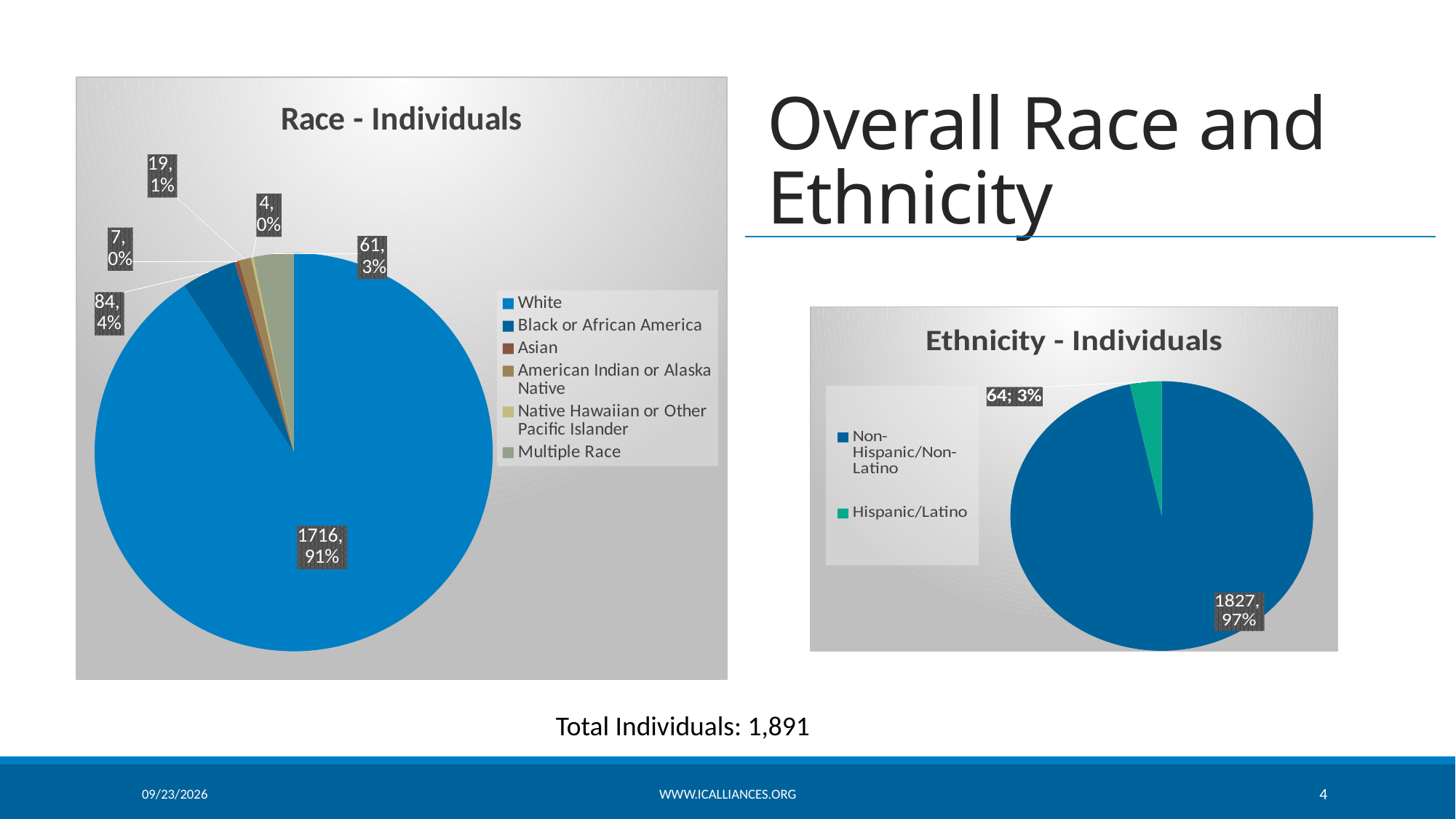
In the Race - Individuals chart, how many categories does the legend list? 6 In the Ethnicity - Individuals chart, which category has the smaller slice? Hispanic/Latino In the Race - Individuals chart, what is the difference between the White count and the Black or African America count? 1632 What kind of chart is the Ethnicity - Individuals chart? Pie chart In the Ethnicity - Individuals chart, how many categories does the legend list? 2 In the Race - Individuals chart, how many individuals are White? 1716 In the Race - Individuals chart, which category has the largest slice? White In the Race - Individuals chart, how many individuals are Black or African America? 84 In the Ethnicity - Individuals chart, how many individuals are Non-Hispanic/Non-Latino? 1827 In the Race - Individuals chart, what share of the pie is Multiple Race? 3% In the Race - Individuals chart, what percentage of individuals are White? 91% In the Ethnicity - Individuals chart, what percentage of individuals are Hispanic/Latino? 3%